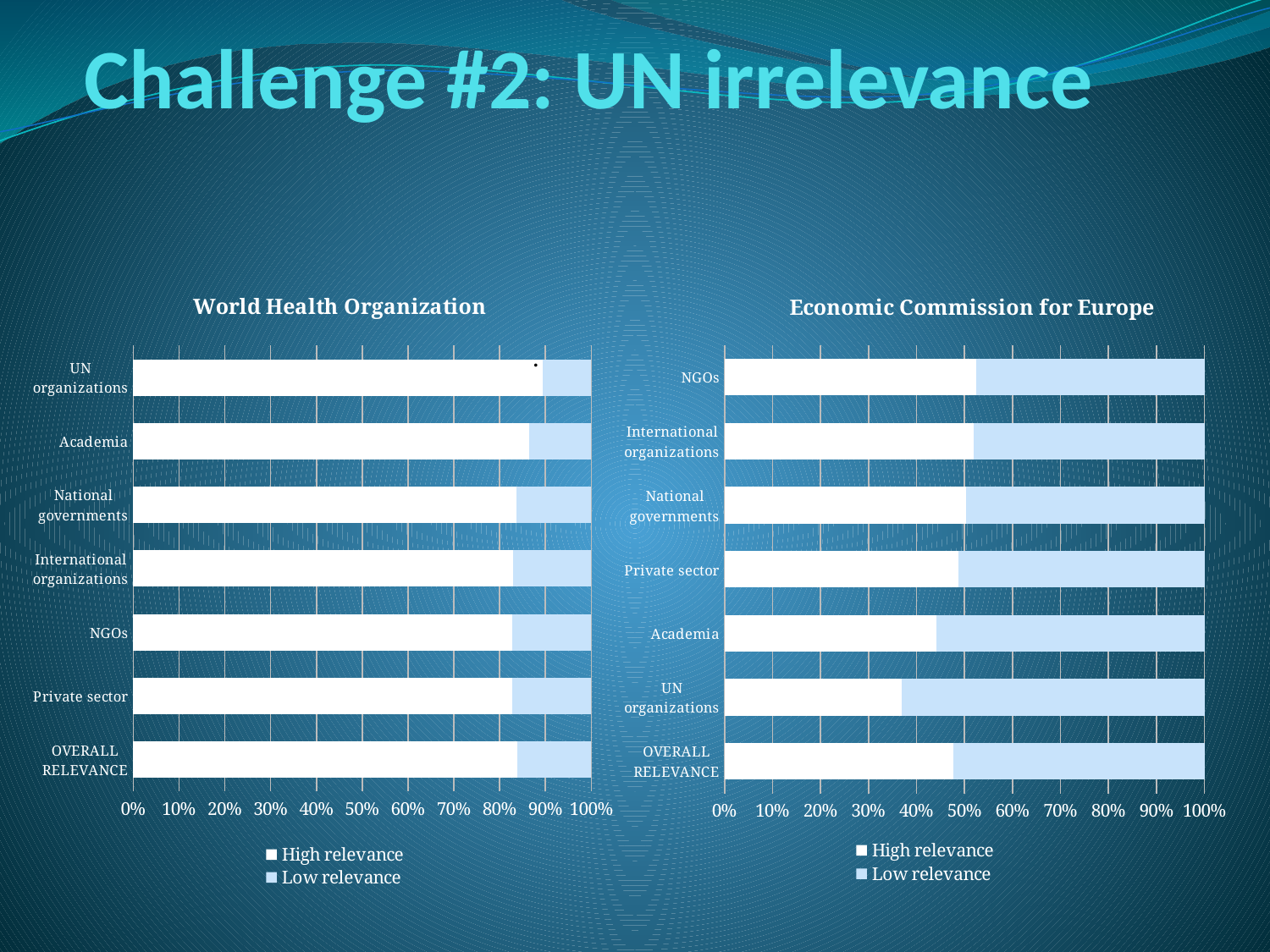
In the World Health Organization chart, is the High relevance value for UN organizations greater or less than 80%? greater In the Economic Commission for Europe chart, is the High relevance value for UN organizations greater or less than 50%? less How many categories are shown on the World Health Organization chart? 7 What are the two legend entries on the World Health Organization chart? High relevance, Low relevance In the World Health Organization chart, is the High relevance value for Private sector greater or less than 70%? greater In the World Health Organization chart, which has the larger High relevance value, UN organizations or Private sector? UN organizations In the Economic Commission for Europe chart, which category has the lowest High relevance value? UN organizations How many categories are shown on the Economic Commission for Europe chart? 7 In the Economic Commission for Europe chart, which has the larger High relevance value, NGOs or UN organizations? NGOs How many series does the legend of the Economic Commission for Europe chart list? 2 What kind of chart is the World Health Organization chart? bar chart